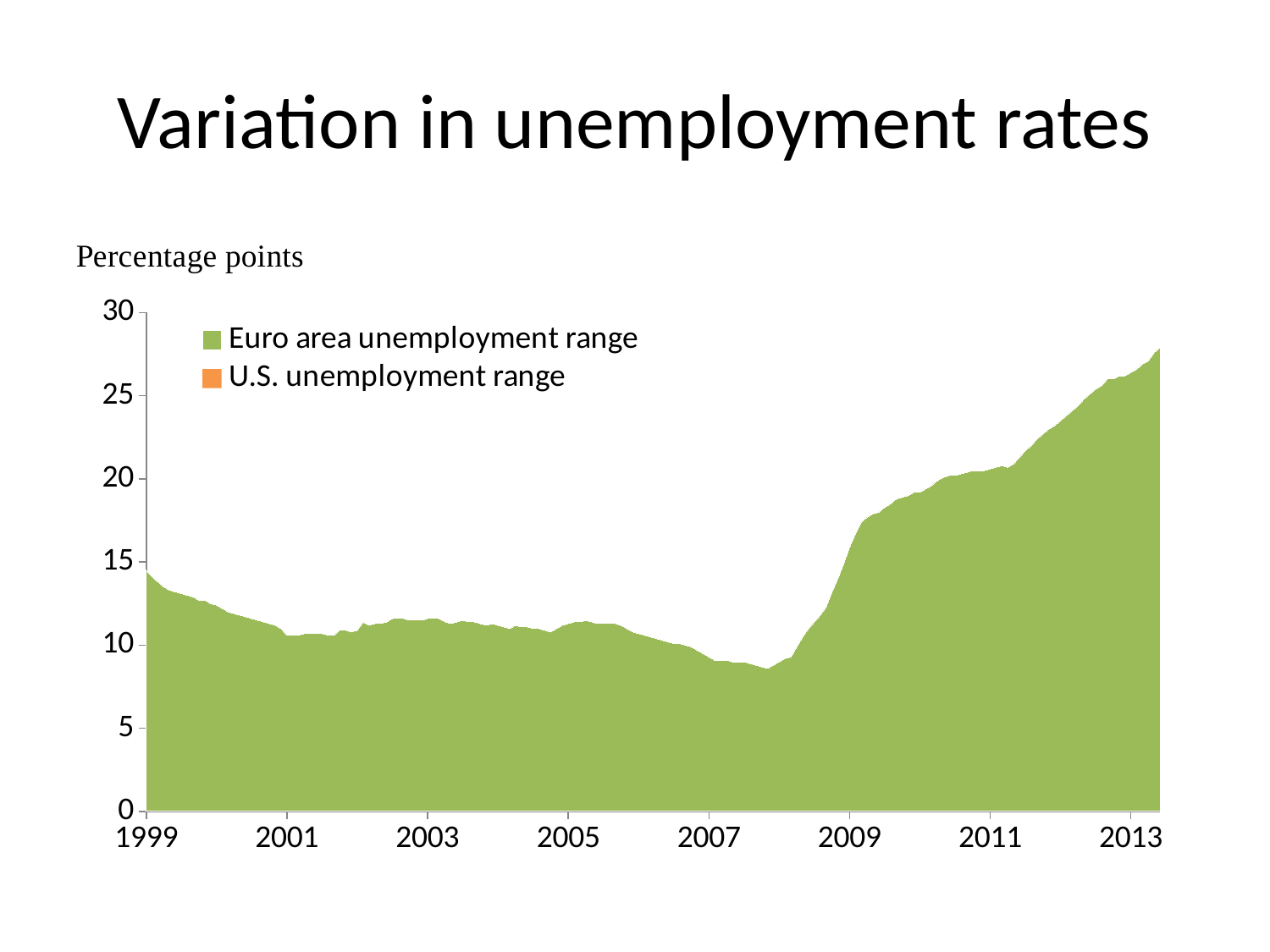
Is the Euro area unemployment range at the start of 2008 greater or less than 10? less What kind of chart is shown on the slide? area chart How many series does the legend list? 2 Is the Euro area unemployment range at the start of 2009 greater or less than 15? greater Is the Euro area unemployment range at the start of 2013 greater or less than 25? greater Does the Euro area unemployment range rise or fall between 2009 and 2013? rise What unit is shown above the vertical axis? Percentage points Does the Euro area unemployment range rise or fall between 1999 and 2001? fall How many year labels are shown on the horizontal axis? 8 What is the title of the chart? Variation in unemployment rates Which is larger, the Euro area unemployment range at the start of 2001 or at the start of 2011? 2011